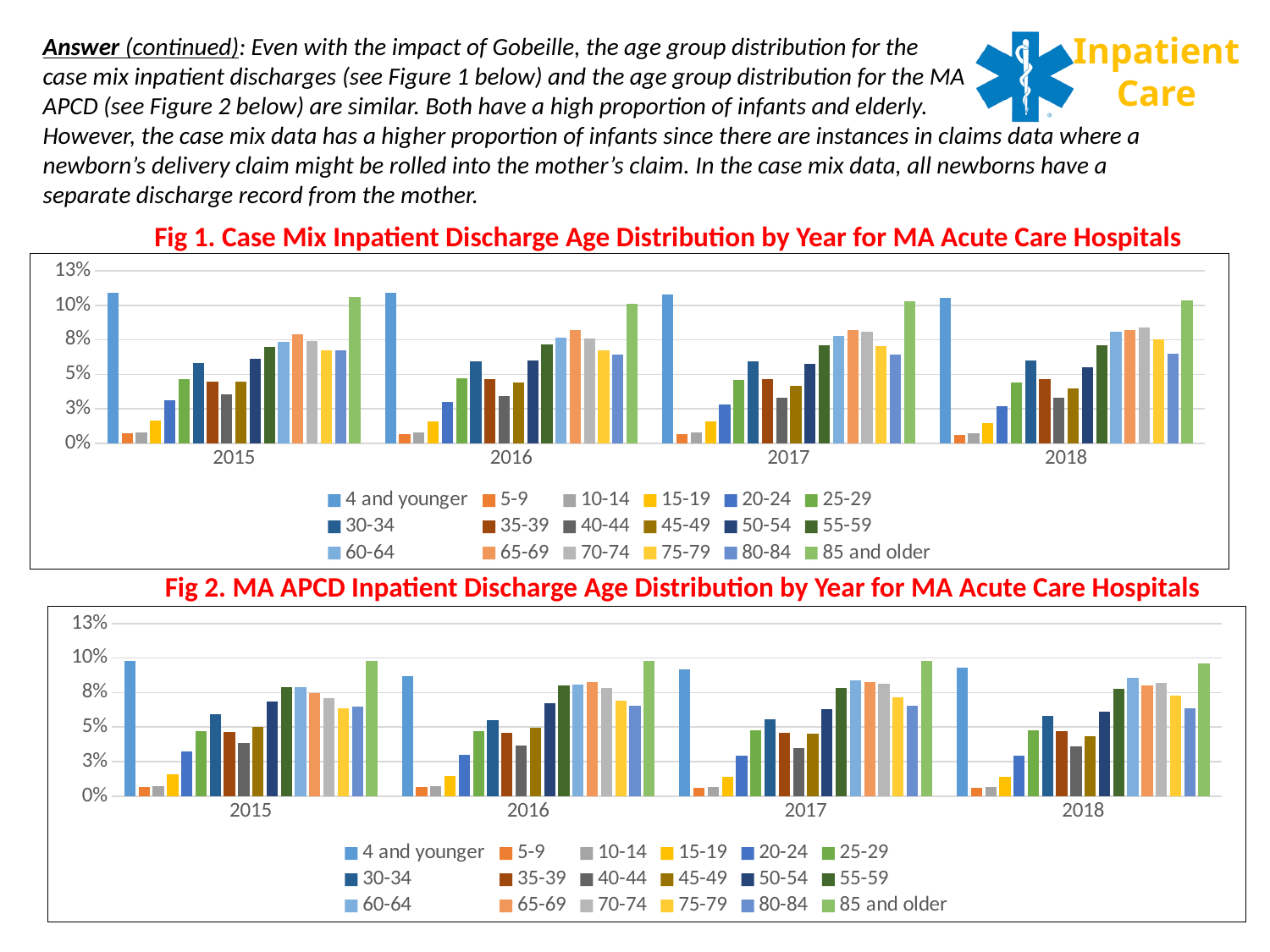
What kind of chart is Fig 1. Case Mix Inpatient Discharge Age Distribution by Year for MA Acute Care Hospitals? bar chart What is the first entry in the legend of Fig 2. MA APCD Inpatient Discharge Age Distribution by Year for MA Acute Care Hospitals? 4 and younger In Fig 1. Case Mix Inpatient Discharge Age Distribution by Year, which is larger in 2015: 30-34 or 20-24? 30-34 In Fig 1. Case Mix Inpatient Discharge Age Distribution by Year, is the value for 4 and younger in 2016 greater or less than 10%? greater In Fig 2. MA APCD Inpatient Discharge Age Distribution by Year, is the value for 30-34 in 2015 greater or less than 5%? greater How many years are shown on the x axis of Fig 1. Case Mix Inpatient Discharge Age Distribution by Year for MA Acute Care Hospitals? 4 In Fig 2. MA APCD Inpatient Discharge Age Distribution by Year, which is larger in 2016: 85 and older or 4 and younger? 85 and older In Fig 2. MA APCD Inpatient Discharge Age Distribution by Year, is the value for 4 and younger in 2016 greater or less than 10%? less In Fig 2. MA APCD Inpatient Discharge Age Distribution by Year, which is larger in 2018: 15-19 or 25-29? 25-29 How many series does the legend of Fig 2. MA APCD Inpatient Discharge Age Distribution by Year for MA Acute Care Hospitals list? 18